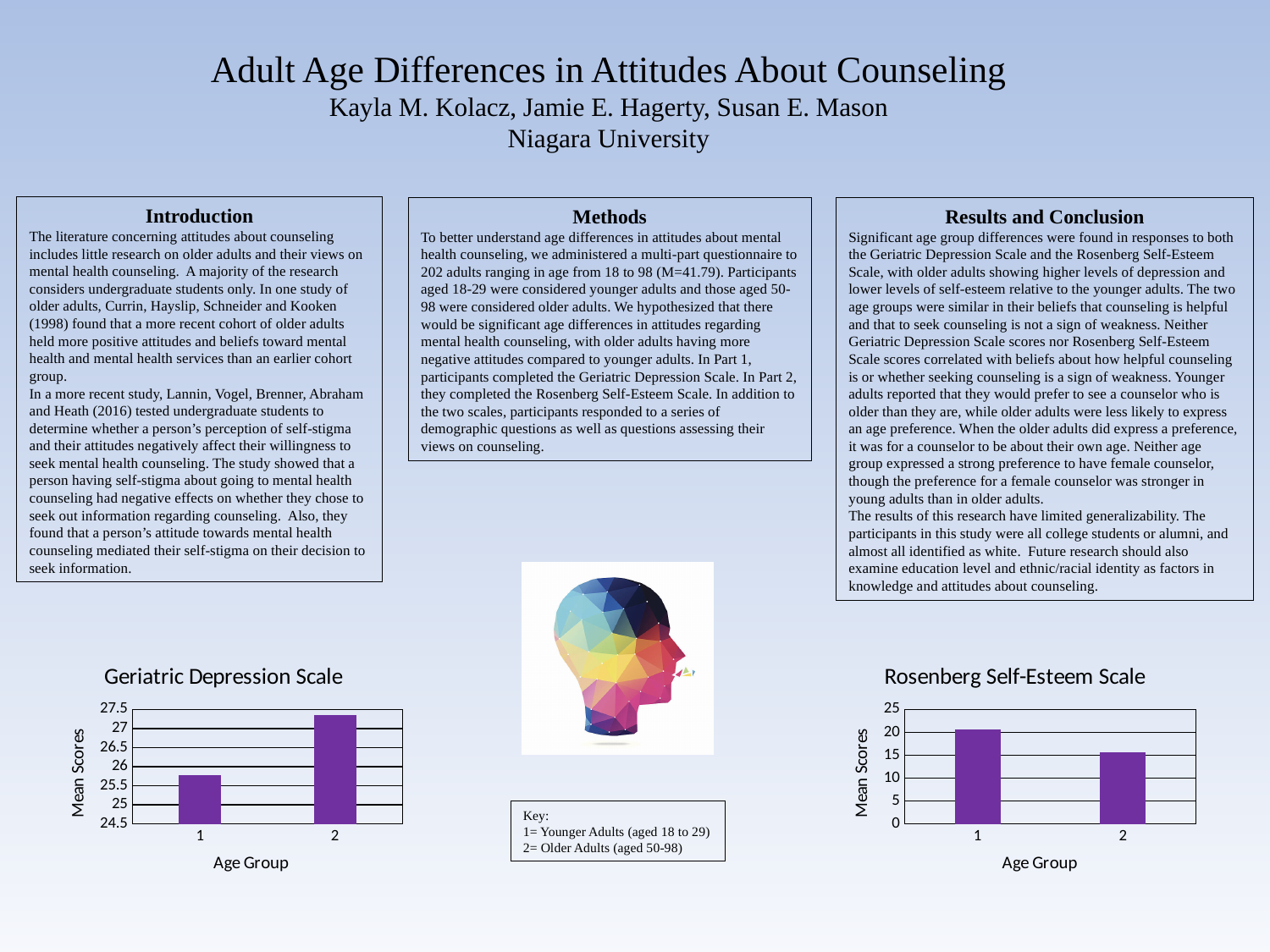
In the Rosenberg Self-Esteem Scale chart, is the value for age group 2 greater or less than 20? less In the Geriatric Depression Scale chart, which age group has the higher mean score? 2 In the Geriatric Depression Scale chart, is the value for age group 2 greater or less than 27? greater In the Rosenberg Self-Esteem Scale chart, do the mean scores rise or fall from age group 1 to age group 2? fall What is the x-axis label of the Geriatric Depression Scale chart? Age Group In the Geriatric Depression Scale chart, do the mean scores rise or fall from age group 1 to age group 2? rise In the Rosenberg Self-Esteem Scale chart, which age group has the lower mean score? 2 What is the y-axis label of the Rosenberg Self-Esteem Scale chart? Mean Scores In the Geriatric Depression Scale chart, is the value for age group 1 greater or less than 26? less How many age groups are plotted in the Geriatric Depression Scale chart? 2 What type of chart is the Geriatric Depression Scale chart? bar chart